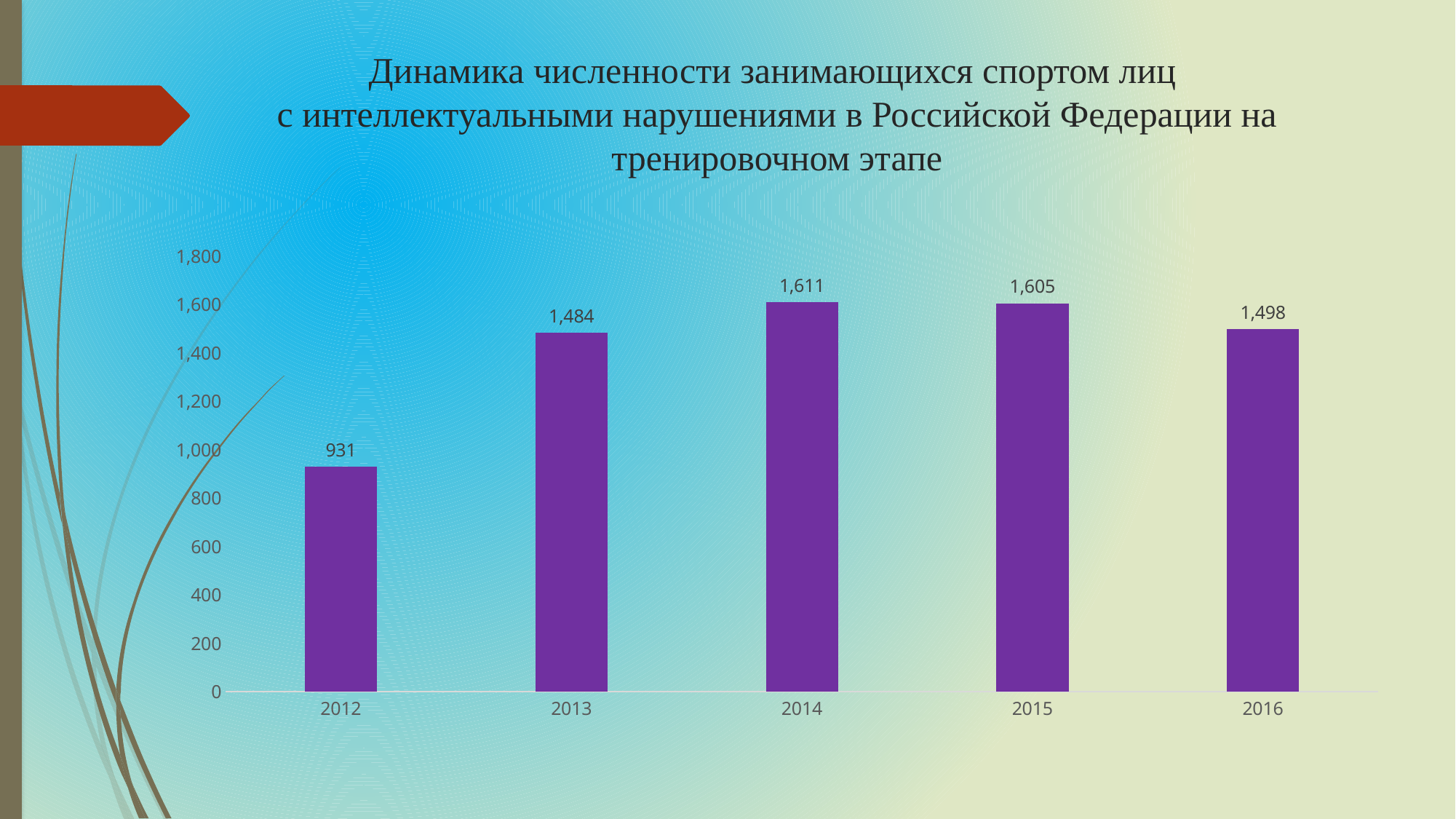
What is the value for 2014? 1,611 Which is larger, the value for 2013 or the value for 2016? 2016 What is the difference between the values for 2015 and 2016? 107 Which year has the lowest value? 2012 How many years are shown on the x axis? 5 What is the value for 2012? 931 What kind of chart is shown on the slide? bar chart Which year has the highest value? 2014 Is the value for 2012 greater or less than 1,000? less Do the values rise or fall from 2012 to 2014? rise What is the difference between the values for 2013 and 2012? 553 What is the value for 2016? 1,498